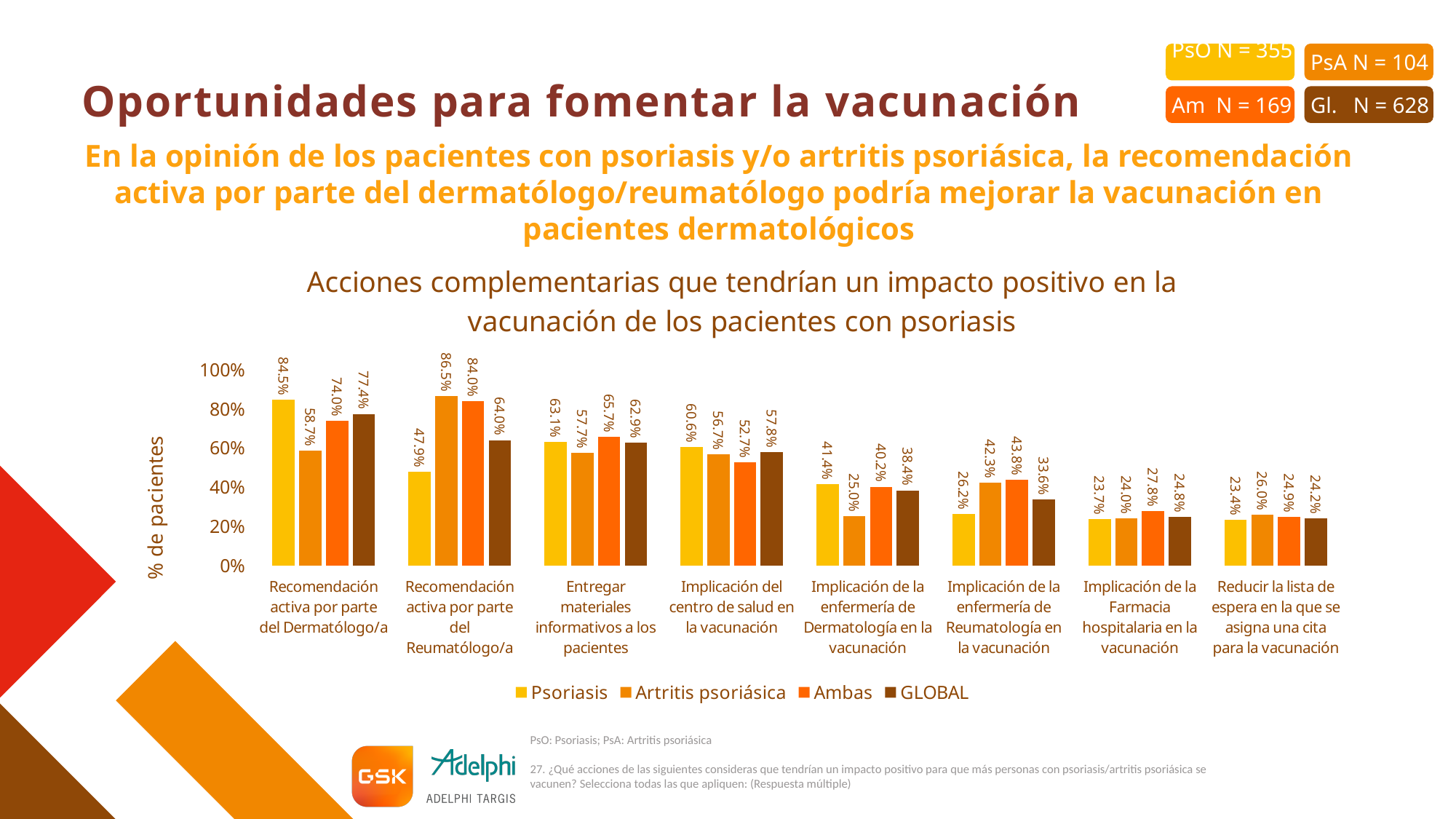
How many series does the legend list? 4 How many categories are shown on the x axis of the chart? 8 What is the Psoriasis value for 'Recomendación activa por parte del Dermatólogo/a'? 84.5% What is the difference between the Artritis psoriásica and Psoriasis values for 'Recomendación activa por parte del Reumatólogo/a'? 38.6% What is the label of the y axis of the chart? % de pacientes What is the GLOBAL value for 'Recomendación activa por parte del Reumatólogo/a'? 64.0% What kind of chart is shown on the slide? Bar chart What is the Ambas value for 'Entregar materiales informativos a los pacientes'? 65.7% Which category has the lowest Psoriasis value? Reducir la lista de espera en la que se asigna una cita para la vacunación For 'Implicación del centro de salud en la vacunación', which is larger: the Psoriasis value or the Ambas value? Psoriasis What is the Artritis psoriásica value for 'Implicación de la enfermería de Dermatología en la vacunación'? 25.0% Which category has the highest GLOBAL value? Recomendación activa por parte del Dermatólogo/a